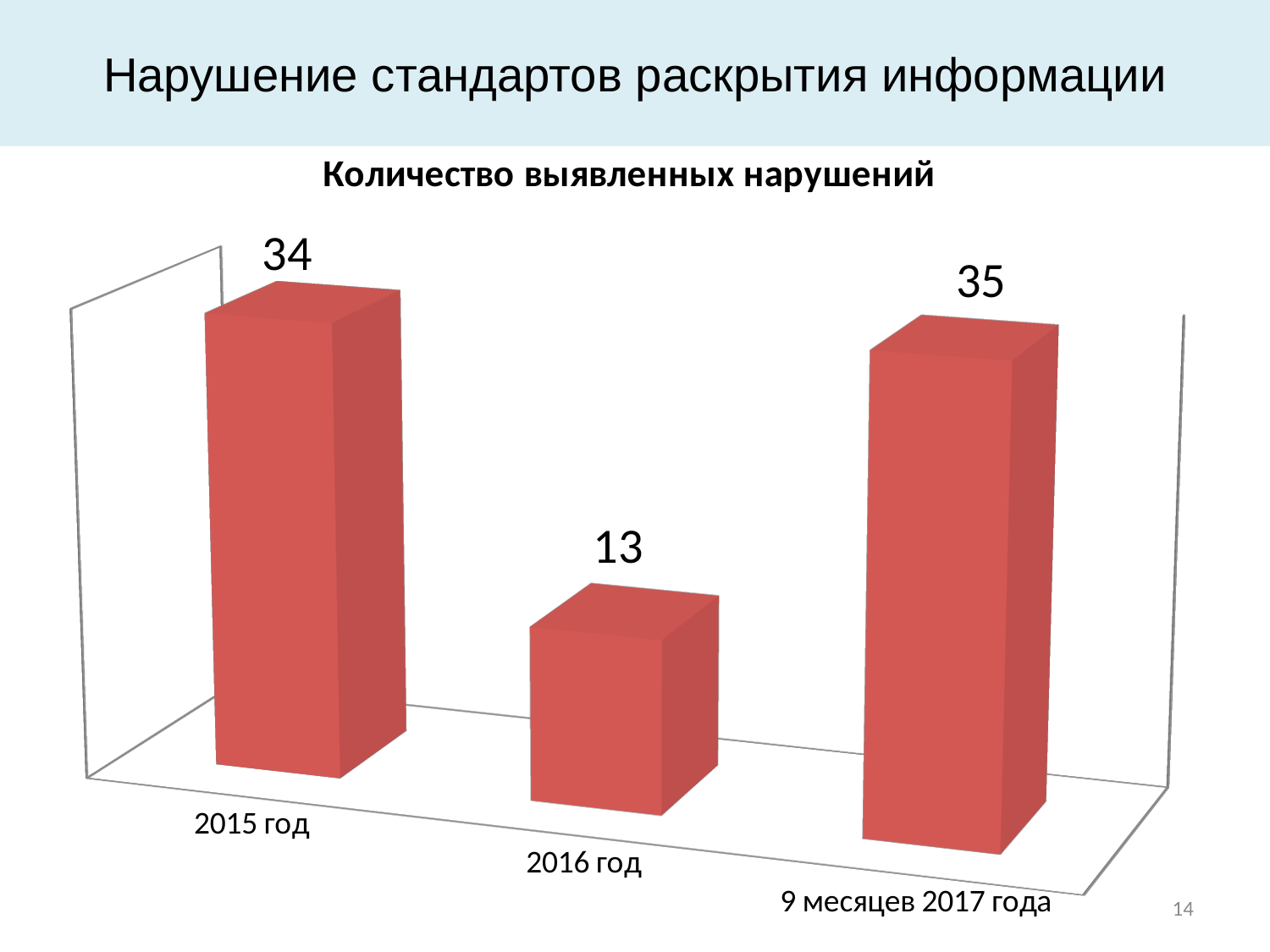
Which is larger, the value for 2015 год or the value for 2016 год? 2015 год Which category has the lowest value? 2016 год What kind of chart is shown on the slide? bar chart What is the difference between the values for 2015 год and 2016 год? 21 What is the value for 9 месяцев 2017 года? 35 How many categories are shown in the chart? 3 What is the title of the chart? Количество выявленных нарушений What is the value for 2015 год? 34 What is the value for 2016 год? 13 What is the difference between the values for 9 месяцев 2017 года and 2016 год? 22 Which category has the highest value? 9 месяцев 2017 года What colour are the bars in the chart? red